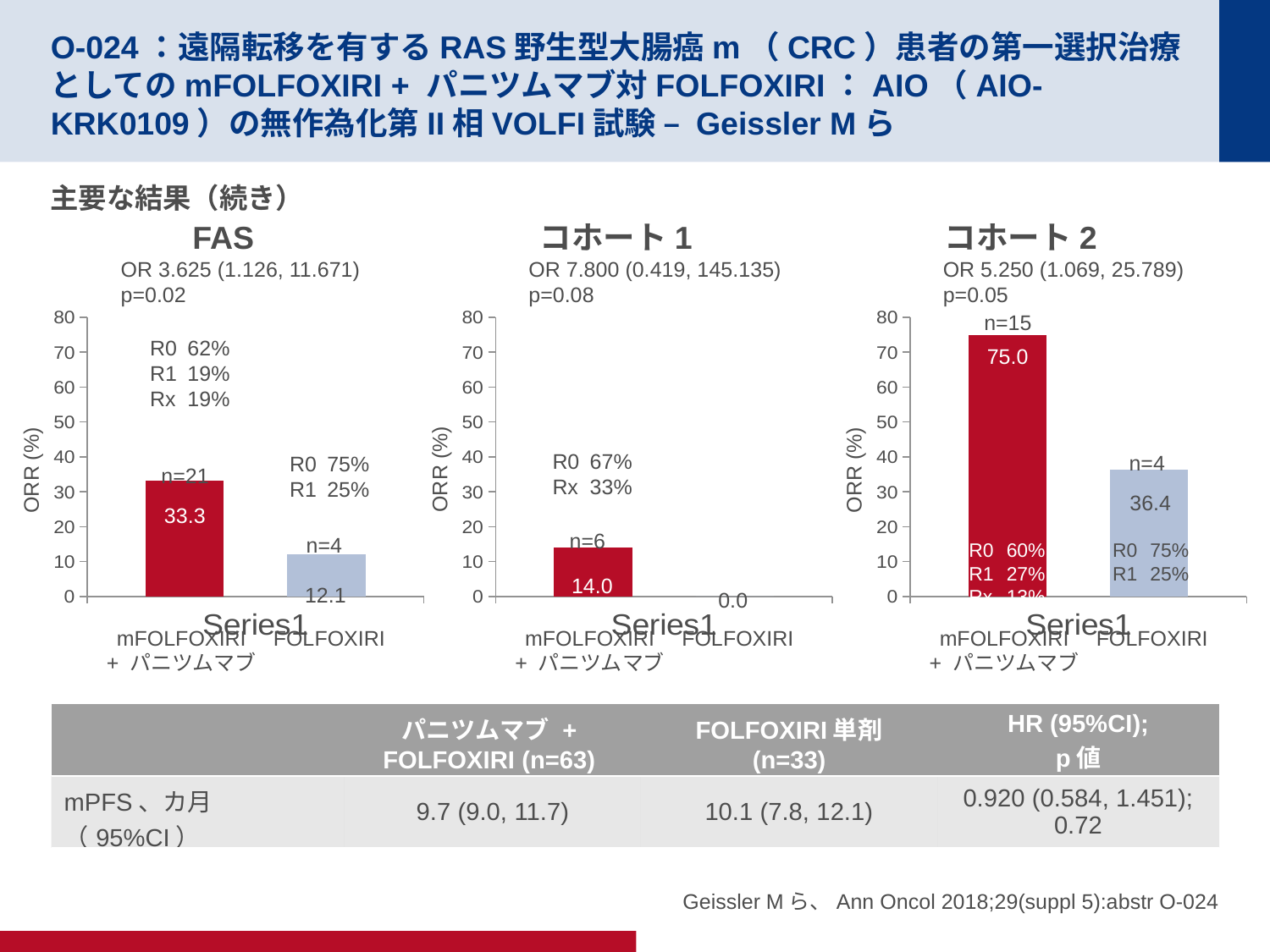
In the コホート 2 chart, is the ORR (%) for FOLFOXIRI greater or less than 40? less In the コホート 1 chart, which treatment has the lower ORR (%)? FOLFOXIRI In the FAS chart, which treatment has the higher ORR (%)? mFOLFOXIRI + パニツムマブ In the コホート 2 chart, what is the difference in ORR (%) between mFOLFOXIRI + パニツムマブ and FOLFOXIRI? 38.6 What kind of chart is the FAS chart? bar chart In the FAS chart, what is the ORR (%) for mFOLFOXIRI + パニツムマブ? 33.3 In the コホート 2 chart, what is the ORR (%) for FOLFOXIRI? 36.4 In the コホート 1 chart, what is the ORR (%) for mFOLFOXIRI + パニツムマブ? 14.0 In the FAS chart, what is the ORR (%) for FOLFOXIRI? 12.1 In the コホート 1 chart, what is the ORR (%) for FOLFOXIRI? 0.0 How many bars are plotted in the コホート 1 chart? 2 In the コホート 2 chart, what is the ORR (%) for mFOLFOXIRI + パニツムマブ? 75.0